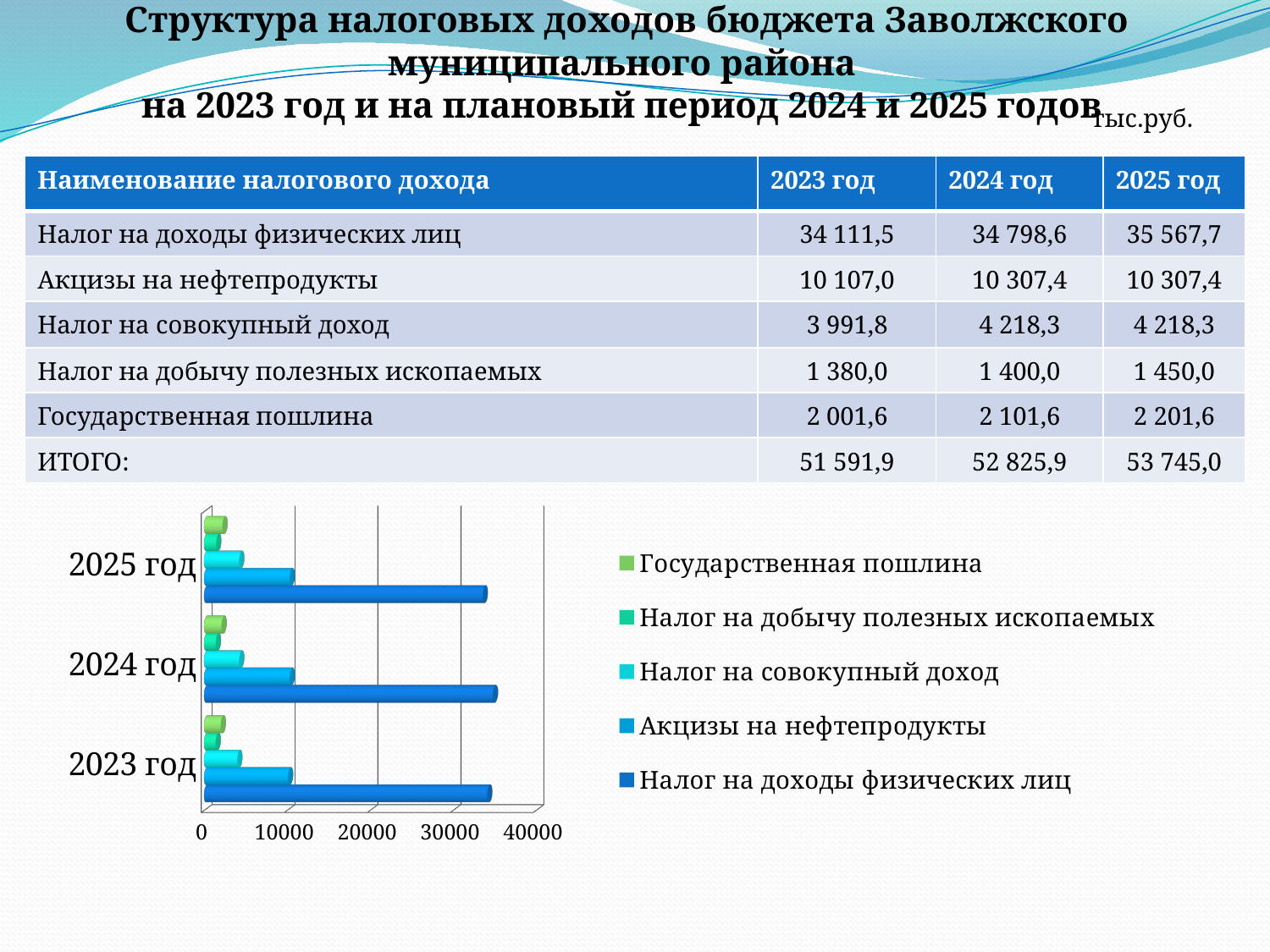
What kind of chart is shown on the slide? bar chart Which legend entry is shown in green on the chart? Государственная пошлина Which series has the longest bar in every year on the chart? Налог на доходы физических лиц How many year categories are shown on the chart's vertical axis? 3 What is the highest tick value shown on the chart's horizontal axis? 40000 Is the value for Налог на доходы физических лиц in 2025 год greater or less than 30000? greater Is the value for Государственная пошлина in 2024 год greater or less than 10000? less In 2024 год, which is larger on the chart: Акцизы на нефтепродукты or Налог на совокупный доход? Акцизы на нефтепродукты Is the value for Налог на совокупный доход in 2023 год greater or less than 10000? less Which series has the shortest bar in every year on the chart? Налог на добычу полезных ископаемых How many series does the chart legend list? 5